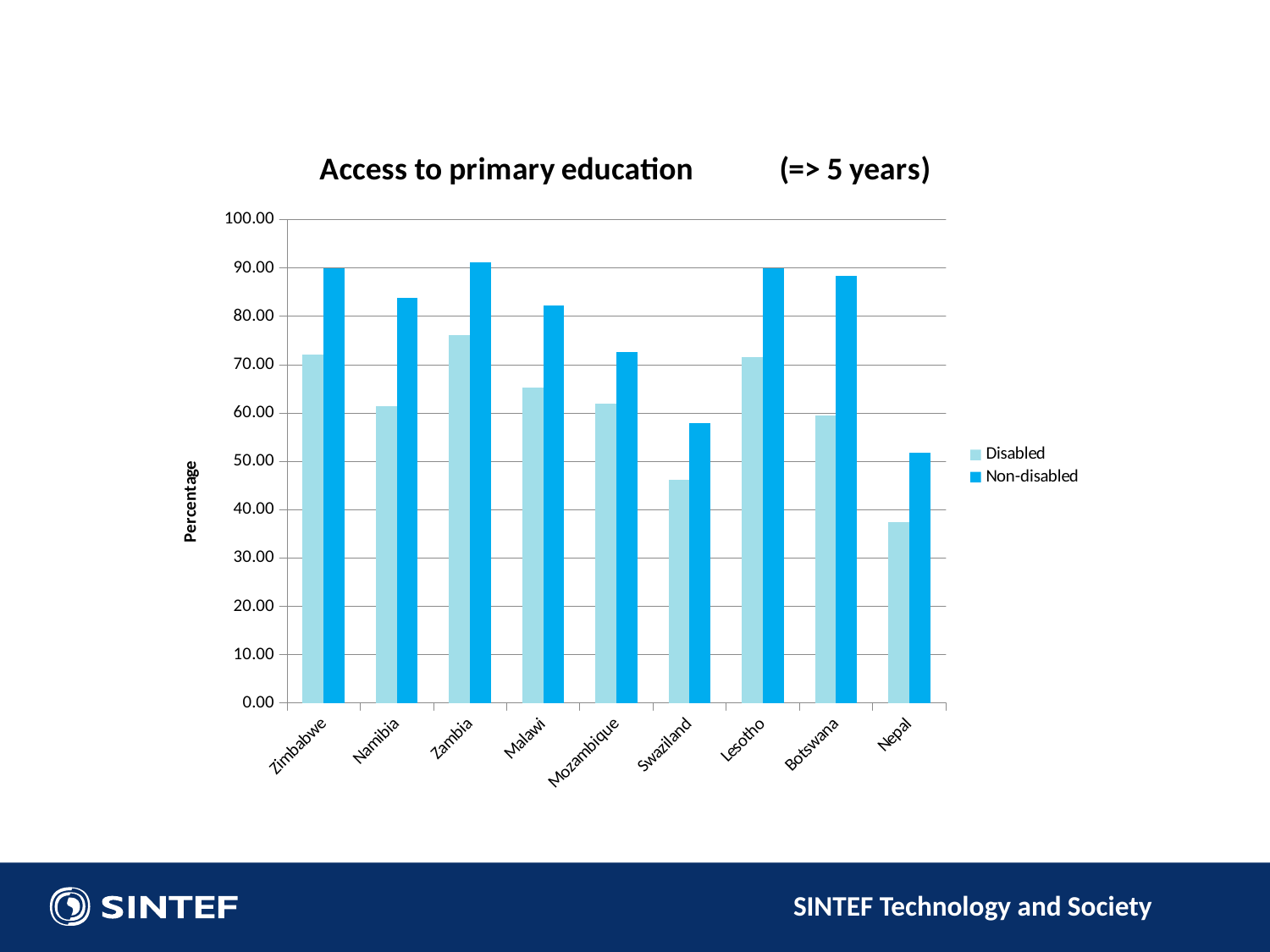
Is the Non-disabled value for Botswana greater or less than 80.00? greater Which country has the lowest value for the Non-disabled series? Nepal How many countries are shown on the x axis of the chart? 9 Is the Disabled value for Nepal greater or less than 40.00? less What is the title of the chart's vertical axis? Percentage Is the Disabled value for Swaziland greater or less than 50.00? less Which country has the lowest value for the Disabled series? Nepal Which country has the highest value for the Disabled series? Zambia Which is larger: the Non-disabled value for Malawi or the Non-disabled value for Mozambique? Malawi What kind of chart is shown on the slide? Bar chart What are the two entries listed in the chart's legend? Disabled and Non-disabled How many series does the chart's legend list? 2